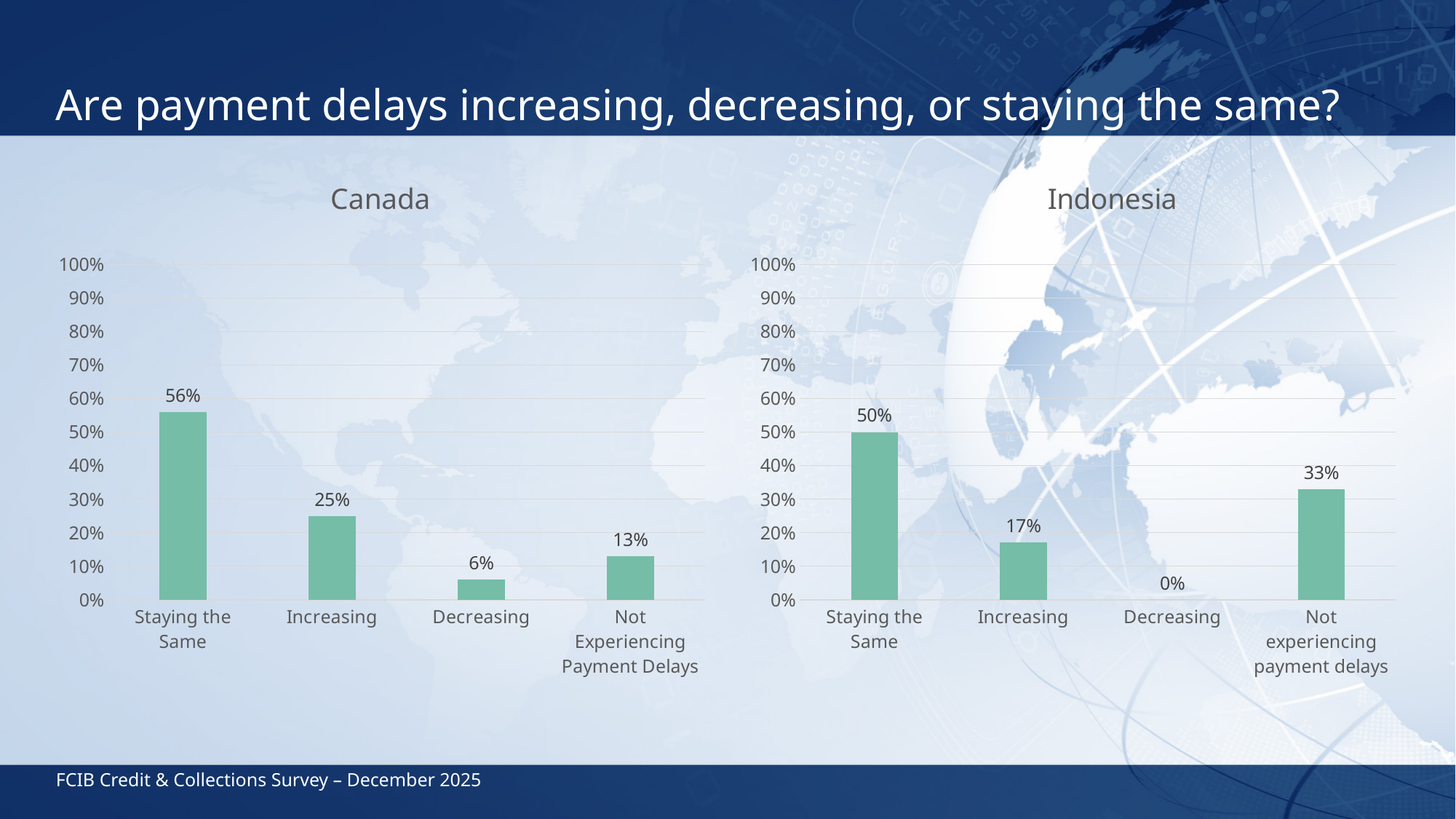
In the Indonesia chart, what is the value for Increasing? 17% In the Indonesia chart, what is the difference between Not experiencing payment delays and Increasing? 16% In the Canada chart, what is the value for Decreasing? 6% In the Indonesia chart, which category has the highest value? Staying the Same How many categories does the Canada chart show? 4 In the Canada chart, what is the value for Staying the Same? 56% In the Canada chart, which category has the lowest value? Decreasing Which is larger: Increasing in the Canada chart or Increasing in the Indonesia chart? Canada What is the title of the chart on the left side of the slide? Canada In the Canada chart, what is the difference between Staying the Same and Increasing? 31% In the Indonesia chart, what is the value for Not experiencing payment delays? 33% What type of chart is the Indonesia chart? Bar chart